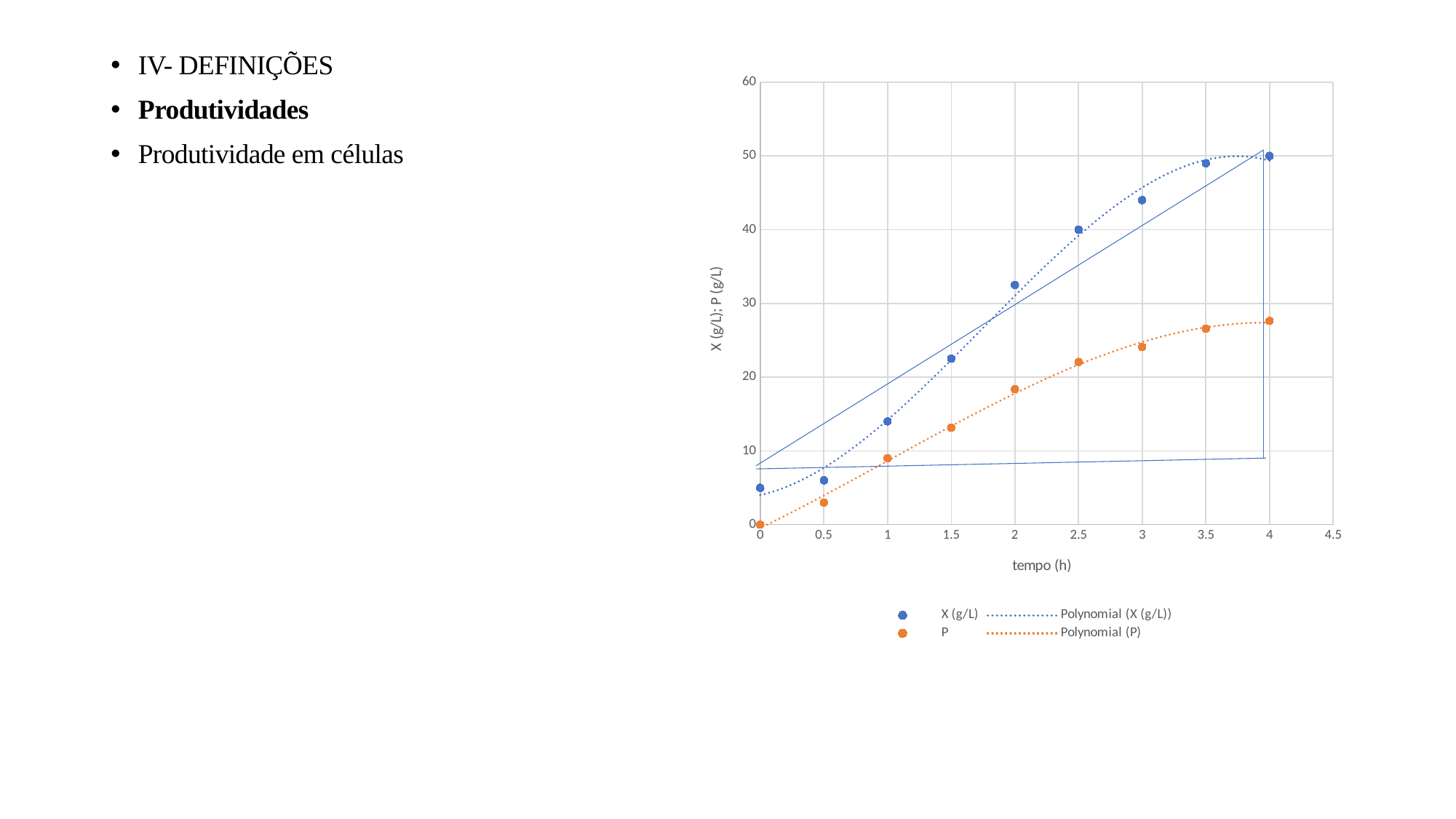
What is the title of the x axis of the chart? tempo (h) Is the value of P at 2 h greater or less than 20? less Is the value of X (g/L) at 3 h greater or less than 40? greater At 4 h, which series has the larger value, X (g/L) or P? X (g/L) What is the value of P at time 0 h? 0 Is the value of P at 4 h greater or less than 30? less Do the values of the P series rise or fall as time increases? rise What kind of chart is shown on the slide? scatter chart How many entries does the chart legend list? 4 How many data points are plotted for the X (g/L) series? 9 What is the title of the y axis of the chart? X (g/L); P (g/L)